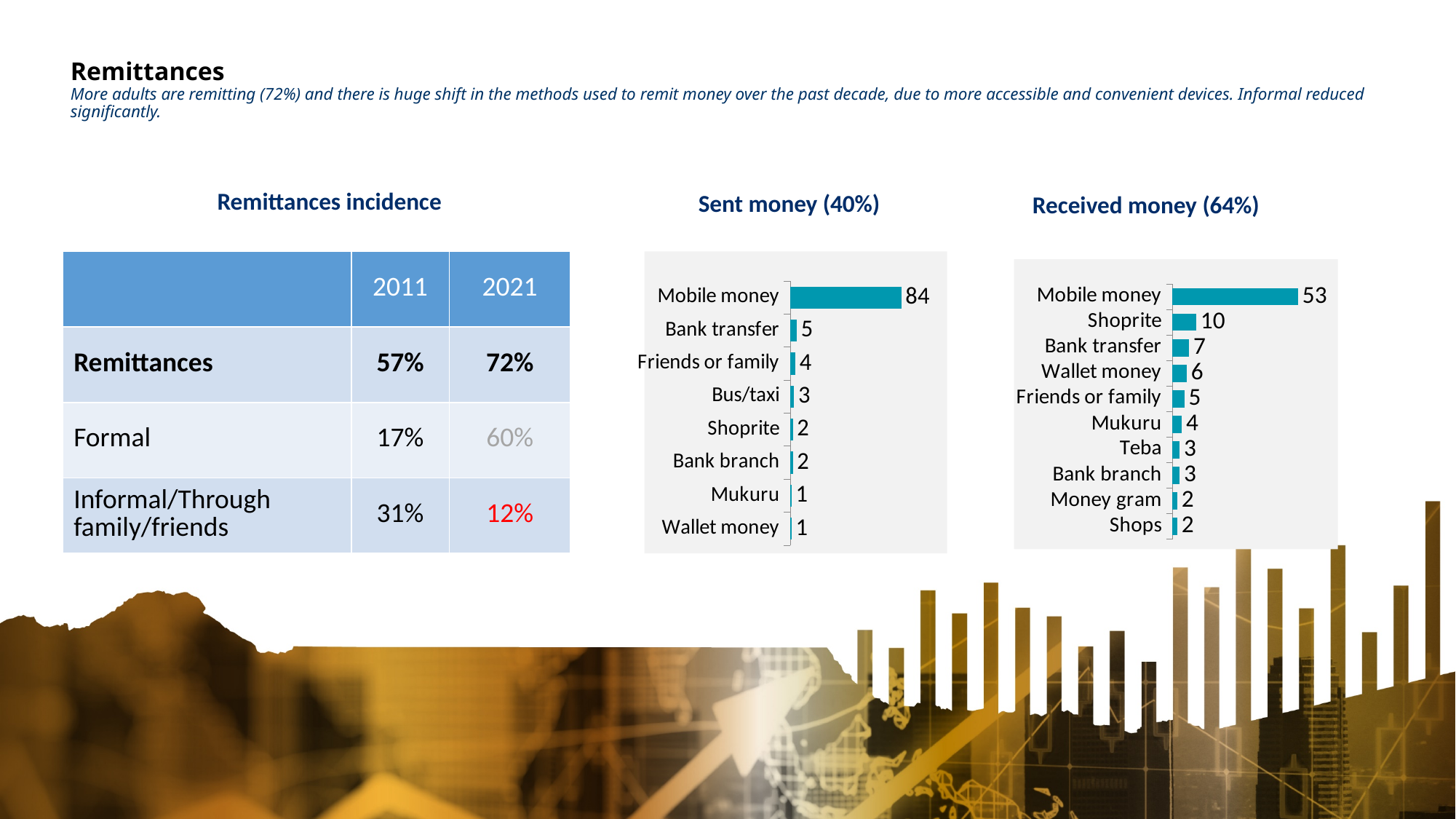
In the 'Received money (64%)' chart, which category has the lowest value? Money gram and Shops (both 2) How many categories are shown in the 'Received money (64%)' chart? 10 In the 'Sent money (40%)' chart, what is the value for Mobile money? 84 In the 'Sent money (40%)' chart, which is larger: Friends or family or Bus/taxi? Friends or family In the 'Sent money (40%)' chart, which category has the highest value? Mobile money In the 'Received money (64%)' chart, what is the value for Shoprite? 10 In the 'Received money (64%)' chart, what is the value for Mukuru? 4 In the 'Received money (64%)' chart, what is the difference between Mobile money and Shoprite? 43 How many categories are shown in the 'Sent money (40%)' chart? 8 What kind of chart is the 'Received money (64%)' chart? Bar chart In the 'Sent money (40%)' chart, what is the difference between Mobile money and Bank transfer? 79 In the 'Received money (64%)' chart, which is larger: Bank transfer or Wallet money? Bank transfer